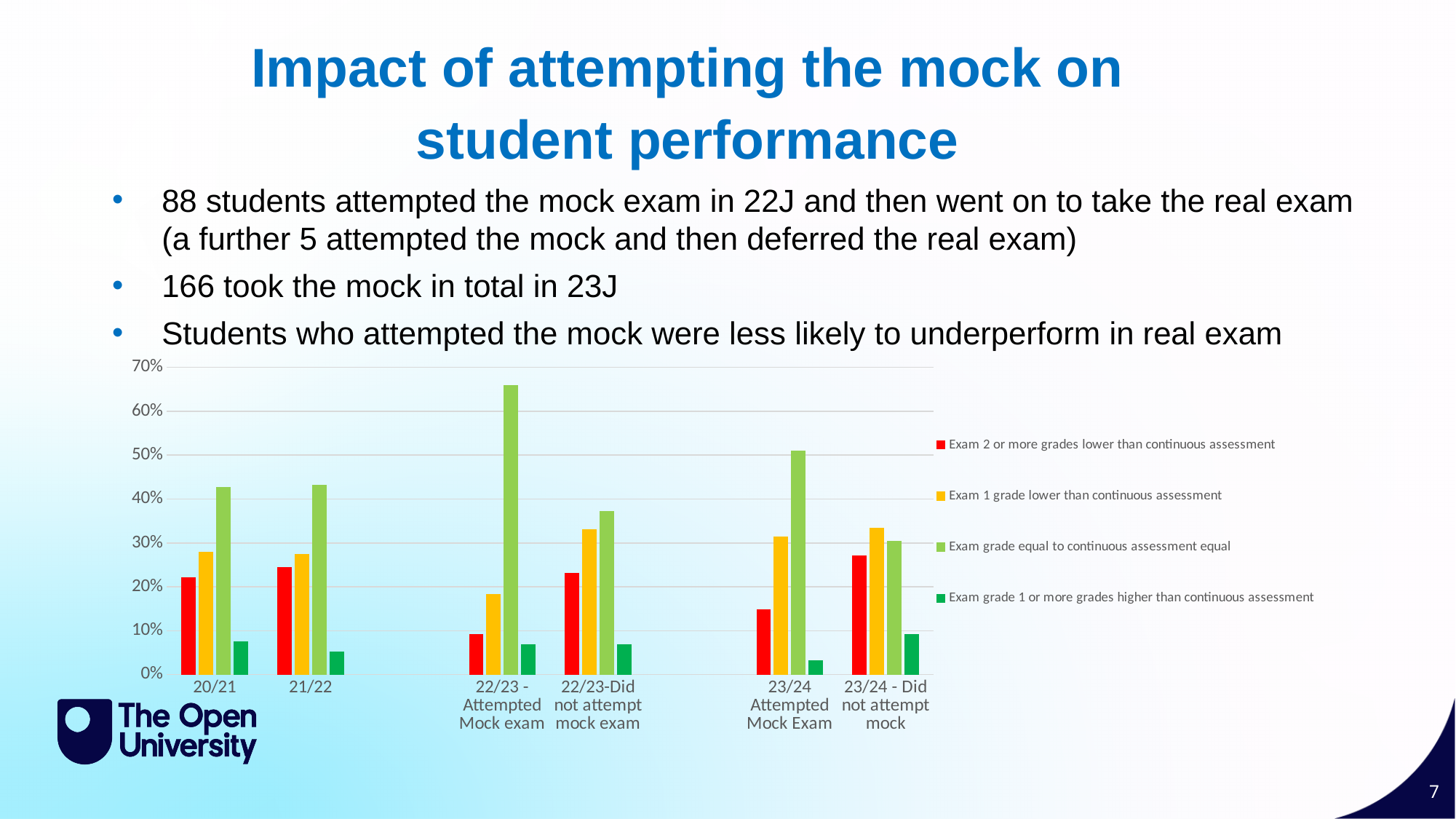
Is the 'Exam grade equal to continuous assessment equal' value for '22/23 - Attempted Mock exam' greater or less than 60%? greater How many categories are shown along the x axis of the chart? 6 What colour represents 'Exam 2 or more grades lower than continuous assessment' in the chart's legend? red Is the 'Exam 2 or more grades lower than continuous assessment' value for '21/22' greater or less than 20%? greater Is the 'Exam grade equal to continuous assessment equal' value for '23/24 Attempted Mock Exam' greater or less than 40%? greater Which category has the highest bar for 'Exam grade equal to continuous assessment equal'? 22/23 - Attempted Mock exam Which has the larger 'Exam 1 grade lower than continuous assessment' value: '22/23 - Attempted Mock exam' or '22/23-Did not attempt mock exam'? 22/23-Did not attempt mock exam How many series does the chart's legend list? 4 What kind of chart is shown on the slide? bar chart Which has the larger 'Exam 2 or more grades lower than continuous assessment' value: '23/24 Attempted Mock Exam' or '23/24 - Did not attempt mock'? 23/24 - Did not attempt mock Which category has the lowest bar for 'Exam grade 1 or more grades higher than continuous assessment'? 23/24 Attempted Mock Exam